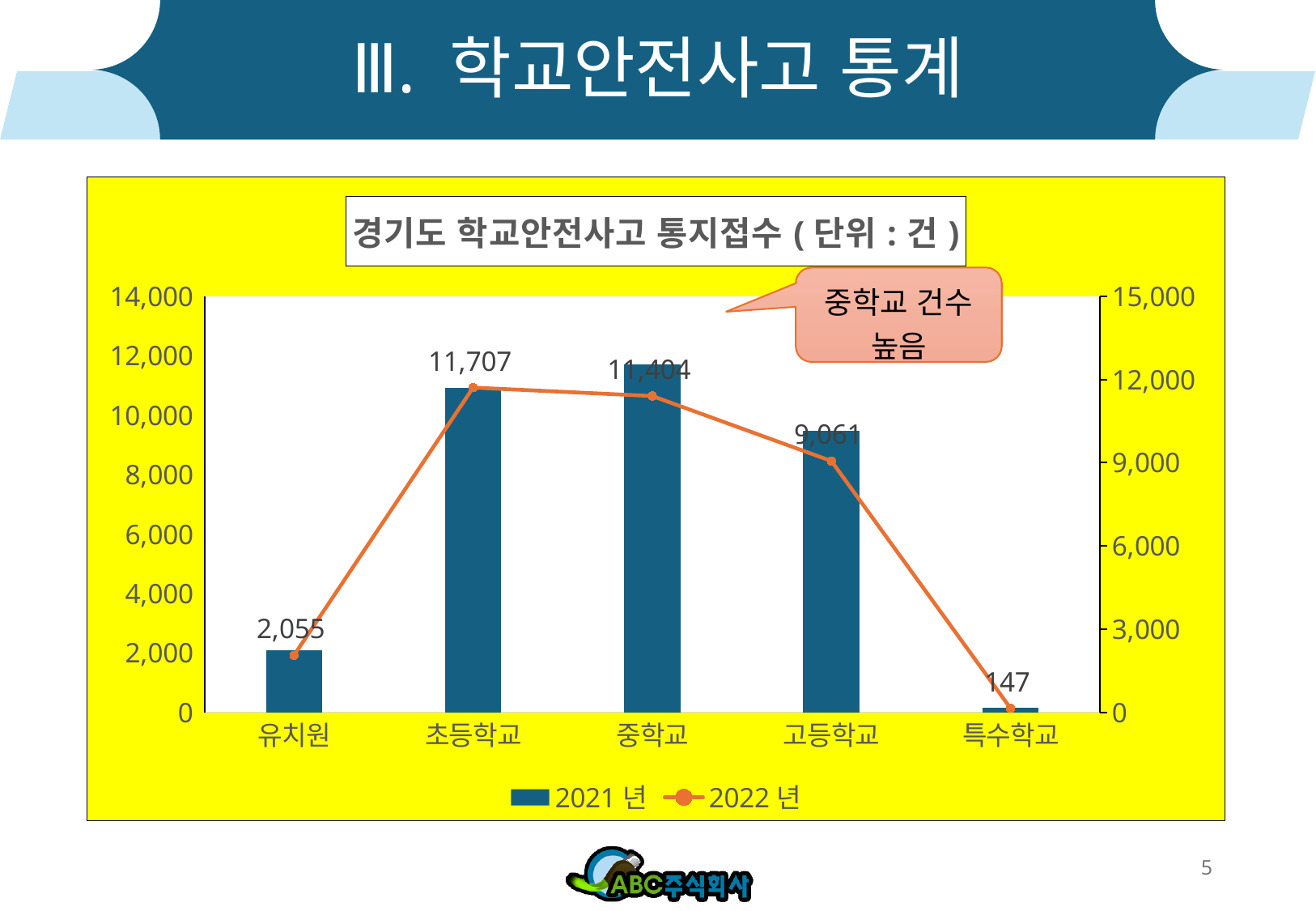
Which category has the lowest 2021 년 value? 특수학교 Which category has the highest 2021 년 value? 중학교 How many school categories are shown on the x axis? 5 Is the 2022 년 value for 고등학교 greater or less than 6,000? greater Which has a larger 2021 년 value, 고등학교 or 유치원? 고등학교 How many series does the legend list? 2 What kind of chart is this? Combined bar and line chart What is the title of the chart? 경기도 학교안전사고 통지접수 ( 단위 : 건 )